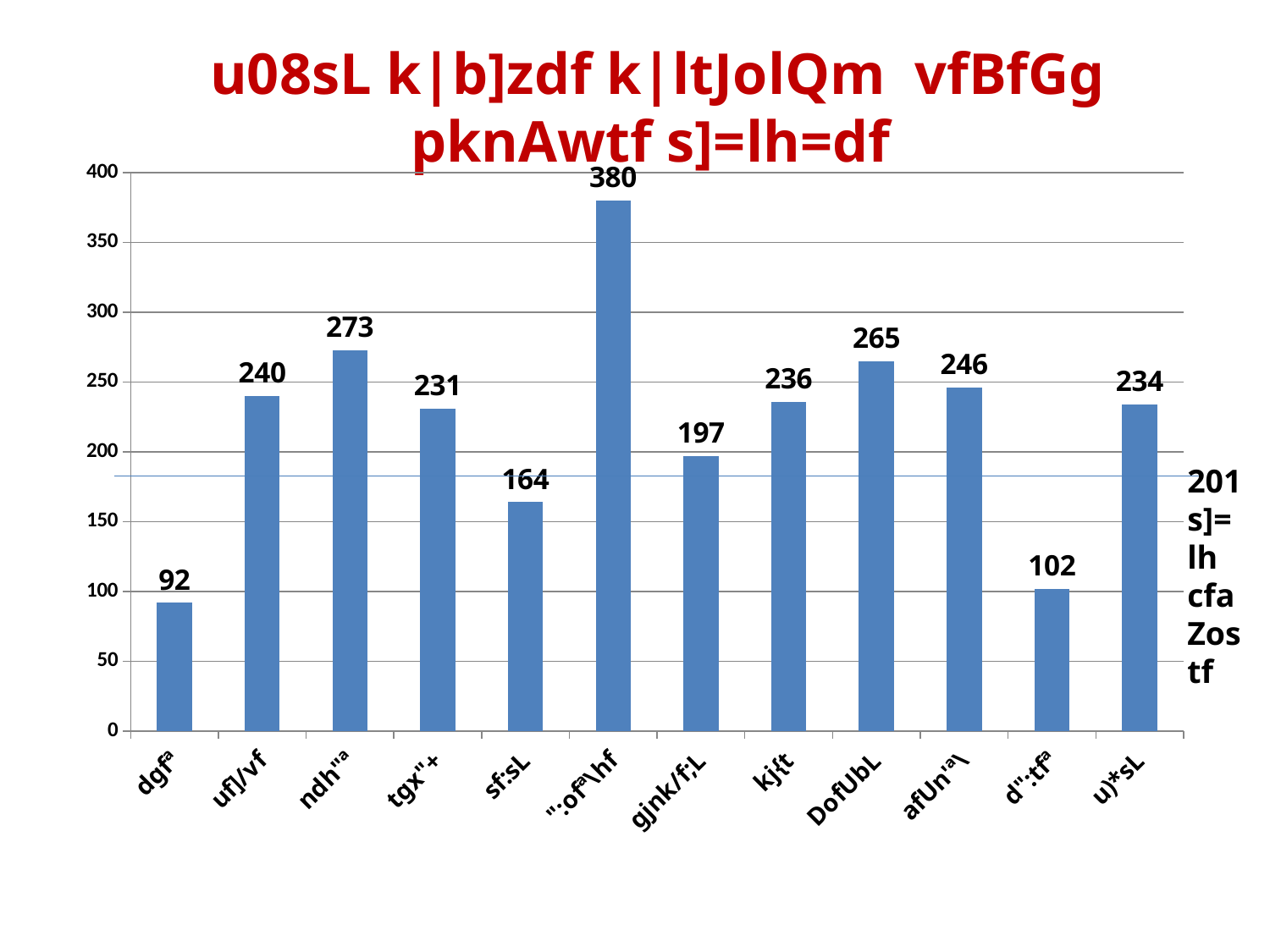
Which category has the highest value? ":ofª\hf What is the value for u)*sL? 234 What is the difference between the highest value and the value for sf:sL? 216 What is the value for DofUbL? 265 Which is larger, the value for ufl/vf or the value for tgx"+? uf]/vf What is the value for sf:sL? 164 What type of chart is shown on the slide? bar chart What is the maximum value shown on the vertical axis? 400 What is the value for kj{t? 236 How many categories are plotted on the x axis? 12 Which category has the lowest value? dgfª What is the difference between the values for DofUbL and dgfª? 173